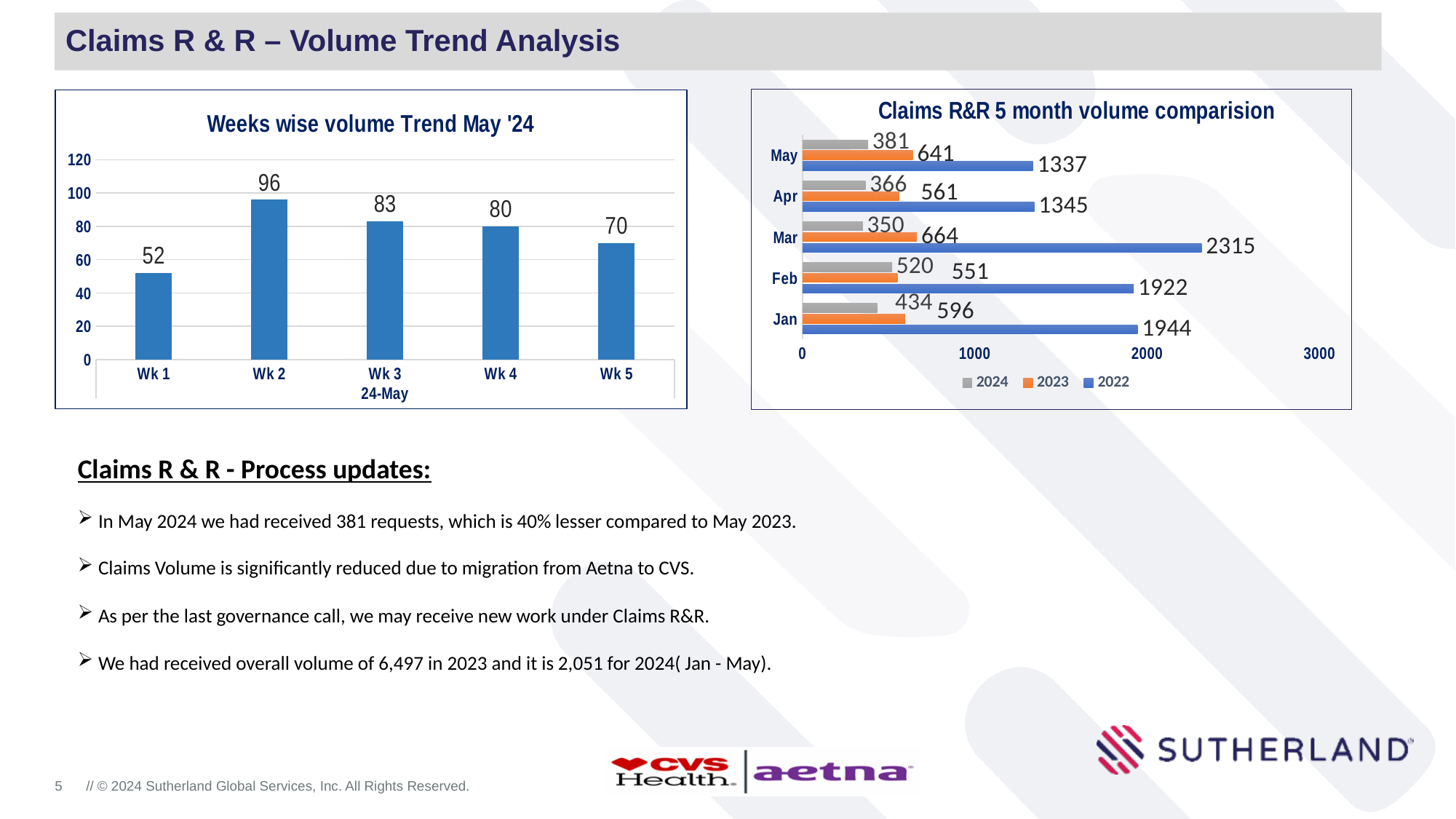
In the 'Claims R&R 5 month volume comparision' chart, which is larger: the 2023 value for Jan or the 2023 value for Apr? Jan What kind of chart is the 'Weeks wise volume Trend May '24' chart? bar chart In the 'Weeks wise volume Trend May '24' chart, what is the value for Wk 2? 96 In the 'Claims R&R 5 month volume comparision' chart, what is the difference between the 2022 and 2023 values for May? 696 In the 'Claims R&R 5 month volume comparision' chart, which month has the highest 2023 value? Mar In the 'Weeks wise volume Trend May '24' chart, what is the difference between Wk 2 and Wk 5? 26 In the 'Claims R&R 5 month volume comparision' chart, what is the 2022 value for Mar? 2315 In the 'Weeks wise volume Trend May '24' chart, do the values rise or fall from Wk 2 to Wk 5? fall In the 'Claims R&R 5 month volume comparision' chart, how many series does the legend list? 3 In the 'Weeks wise volume Trend May '24' chart, which week has the lowest volume? Wk 1 In the 'Claims R&R 5 month volume comparision' chart, what is the 2024 value for Feb? 520 In the 'Weeks wise volume Trend May '24' chart, how many weeks are plotted? 5